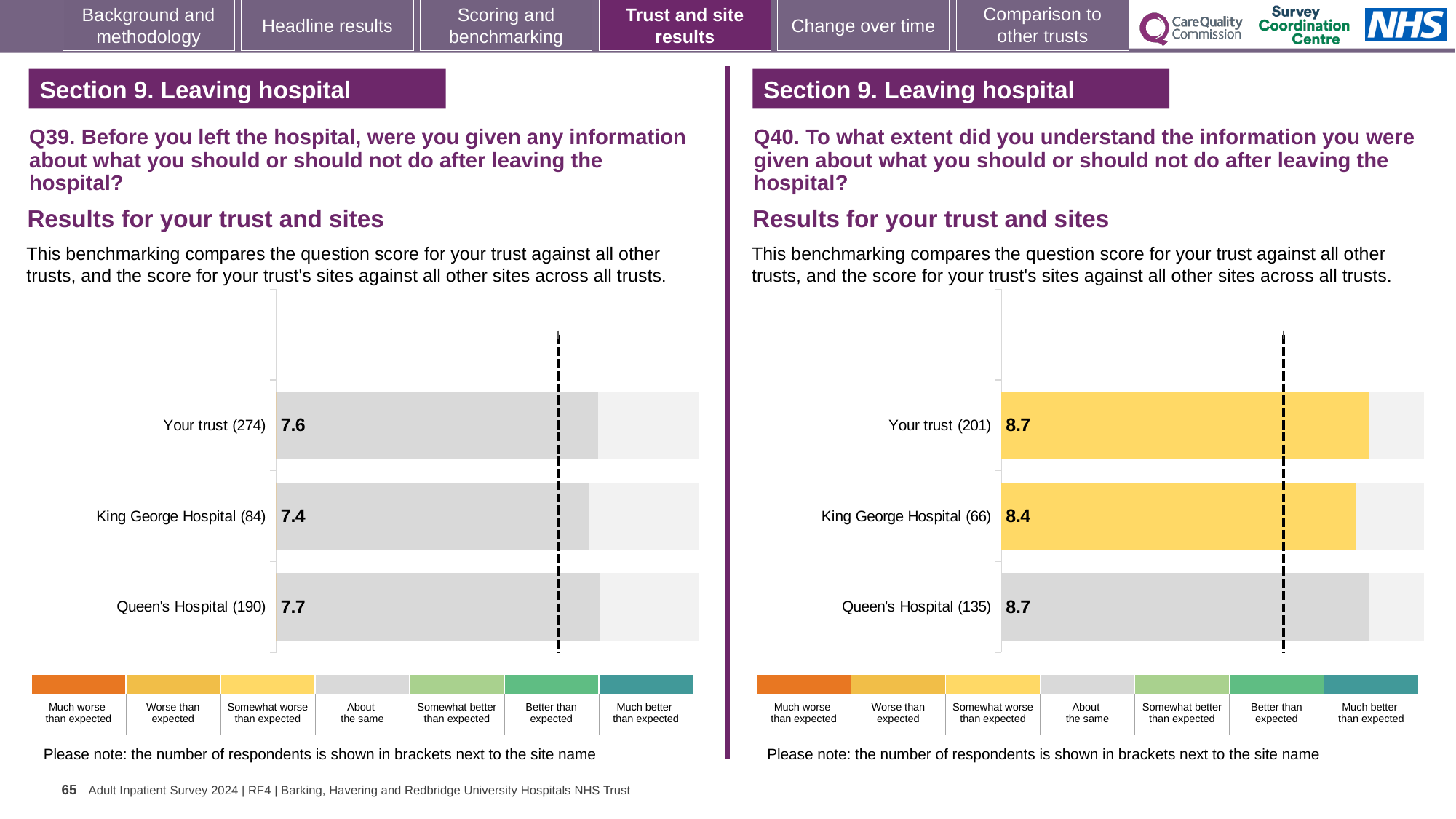
In the Q39 chart on the left, which site or trust has the lowest score? King George Hospital In the Q40 chart on the right, which site has the lowest score? King George Hospital In the Q40 chart on the right, what is the score for King George Hospital? 8.4 In the Q39 chart on the left, what is the score for Your trust? 7.6 In the Q39 chart on the left, what is the difference between the scores for Queen's Hospital and King George Hospital? 0.3 In the Q40 chart on the right, how many respondents are shown in brackets for Your trust? 201 In the Q39 chart on the left, which site or trust has the highest score? Queen's Hospital In the Q40 chart on the right, how many bars are plotted? 3 In the Q40 chart on the right, what is the difference between the scores for Your trust and King George Hospital? 0.3 What type of chart is used in the Q39 chart on the left? Bar chart In the Q40 chart on the right, what is the score for Queen's Hospital? 8.7 In the Q39 chart on the left, what is the score for King George Hospital? 7.4